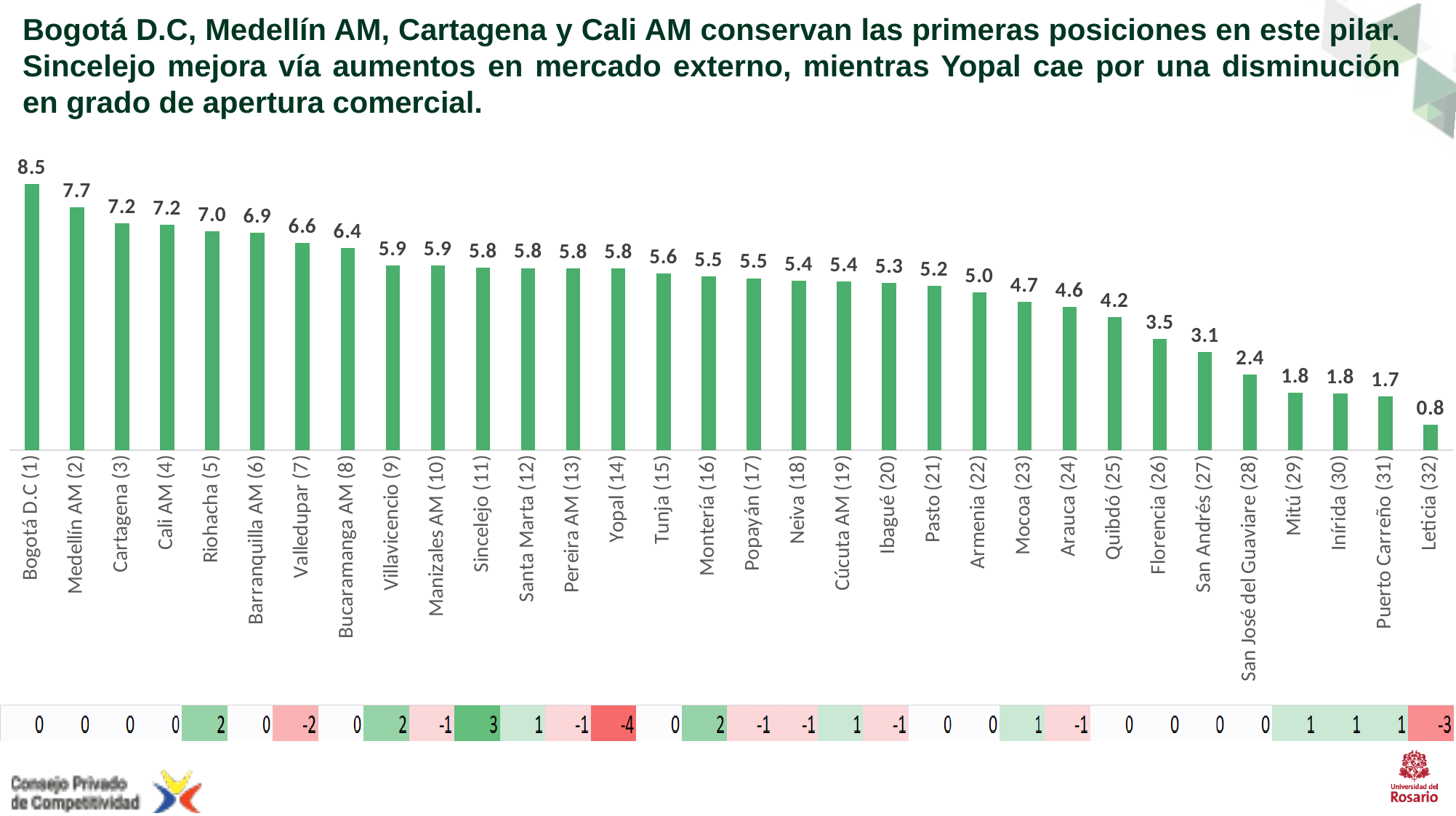
How many cities are shown in the bar chart? 32 What is the value for Yopal (14)? 5.8 Which city has the highest value? Bogotá D.C (1) Which has a larger value, Riohacha (5) or Valledupar (7)? Riohacha (5) What is the value for Bogotá D.C (1)? 8.5 Which city has the lowest value? Leticia (32) What is the difference between the values for Bogotá D.C (1) and Medellín AM (2)? 0.8 Do the values rise or fall from left to right along the x axis? Fall What is the value for Sincelejo (11)? 5.8 What kind of chart is shown on the slide? Bar chart What is the value for Quibdó (25)? 4.2 What is the difference between the values for Florencia (26) and Leticia (32)? 2.7